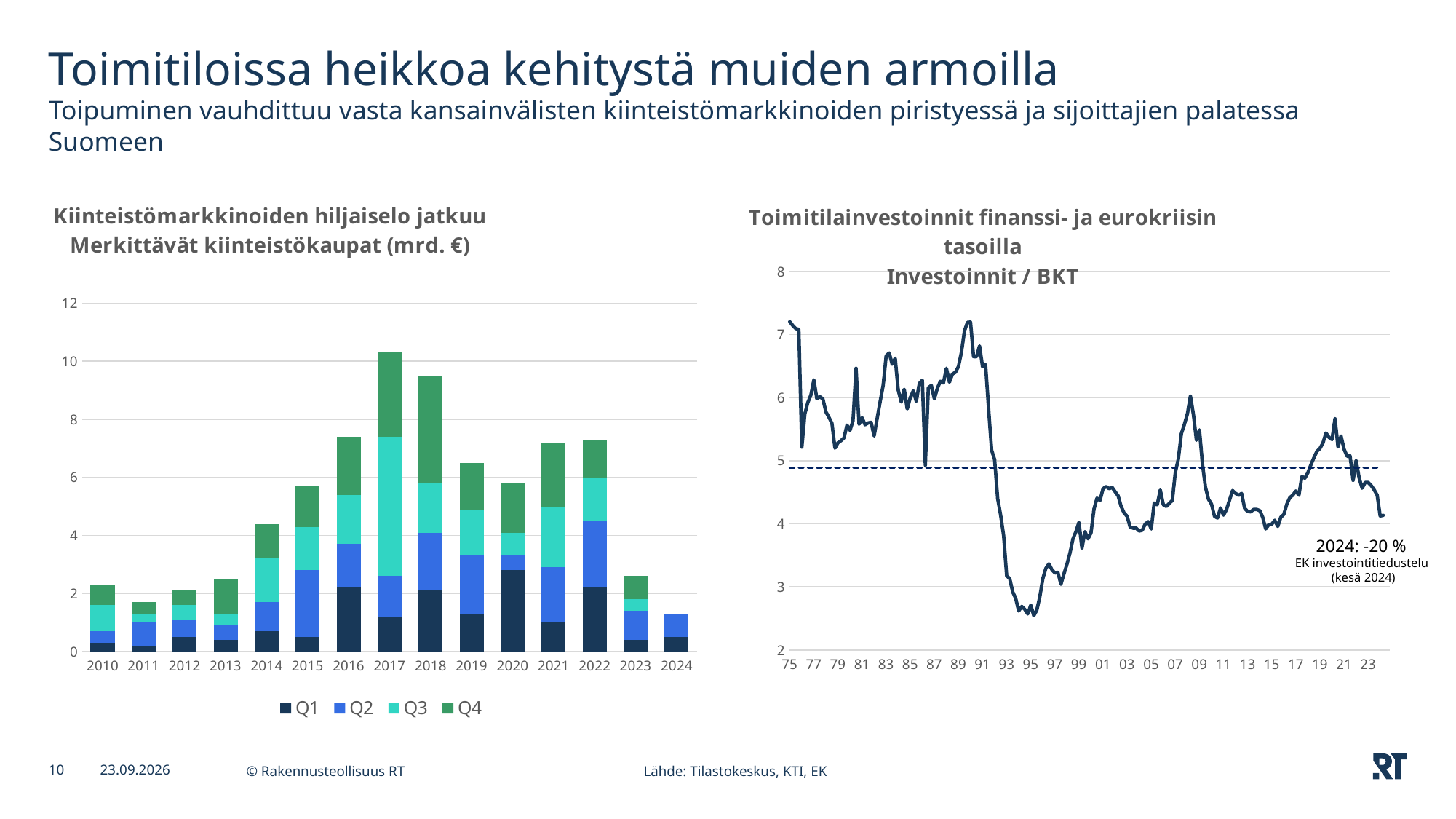
How many series does the legend of the left chart list? 4 In the left chart, which year has the tallest stacked bar? 2017 In the right chart, does the line rise or fall between 2021 and 2023? Falls In the left chart, is the total for 2017 greater or less than 10? greater What kind of chart is the right chart, 'Investoinnit / BKT'? Line chart In the right chart, is the value around 1995 greater or less than 3? less How many years are shown on the x axis of the left chart? 15 In the left chart, which year has the shortest stacked bar? 2024 In the left chart, is the total for 2024 greater or less than 2? less What are the legend entries of the left chart? Q1, Q2, Q3, Q4 In the left chart, which year has the larger total, 2016 or 2015? 2016 What kind of chart is the left chart, 'Merkittävät kiinteistökaupat (mrd. €)'? Stacked bar chart